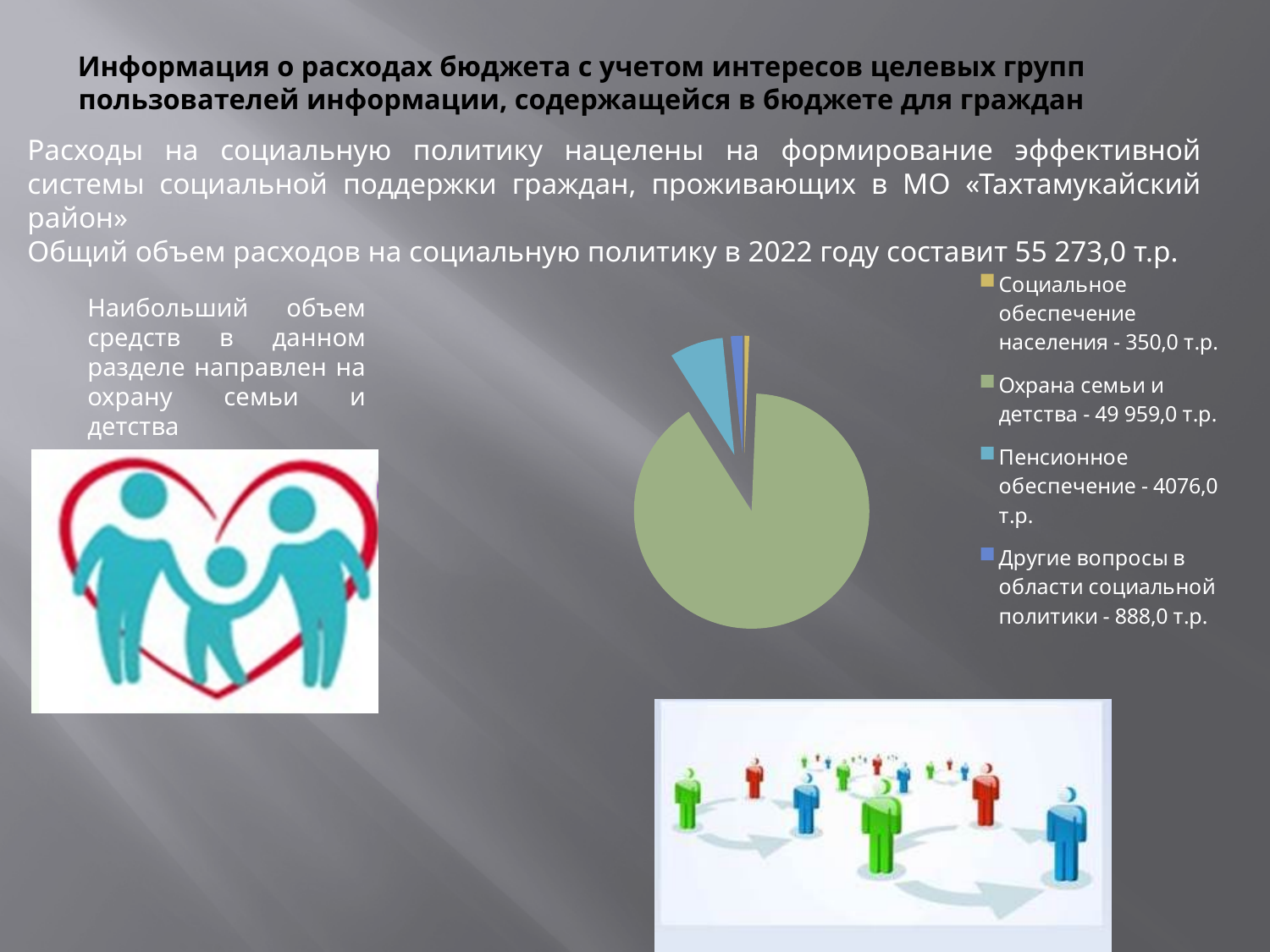
What is the value for Социальное обеспечение населения in the pie chart? 350,0 т.р. Which is larger: Пенсионное обеспечение or Другие вопросы в области социальной политики? Пенсионное обеспечение What is the value for Пенсионное обеспечение in the pie chart? 4076,0 т.р. Which category has the largest slice in the pie chart? Охрана семьи и детства Which category has the smallest slice in the pie chart? Социальное обеспечение населения How many categories does the pie chart show? 4 What is the difference between Охрана семьи и детства and Пенсионное обеспечение? 45 883,0 т.р. What colour is the largest slice of the pie chart? green What is the difference between Другие вопросы в области социальной политики and Социальное обеспечение населения? 538,0 т.р. What is the value for Другие вопросы в области социальной политики in the pie chart? 888,0 т.р. What is the value for Охрана семьи и детства in the pie chart? 49 959,0 т.р. What kind of chart is shown on the slide? pie chart